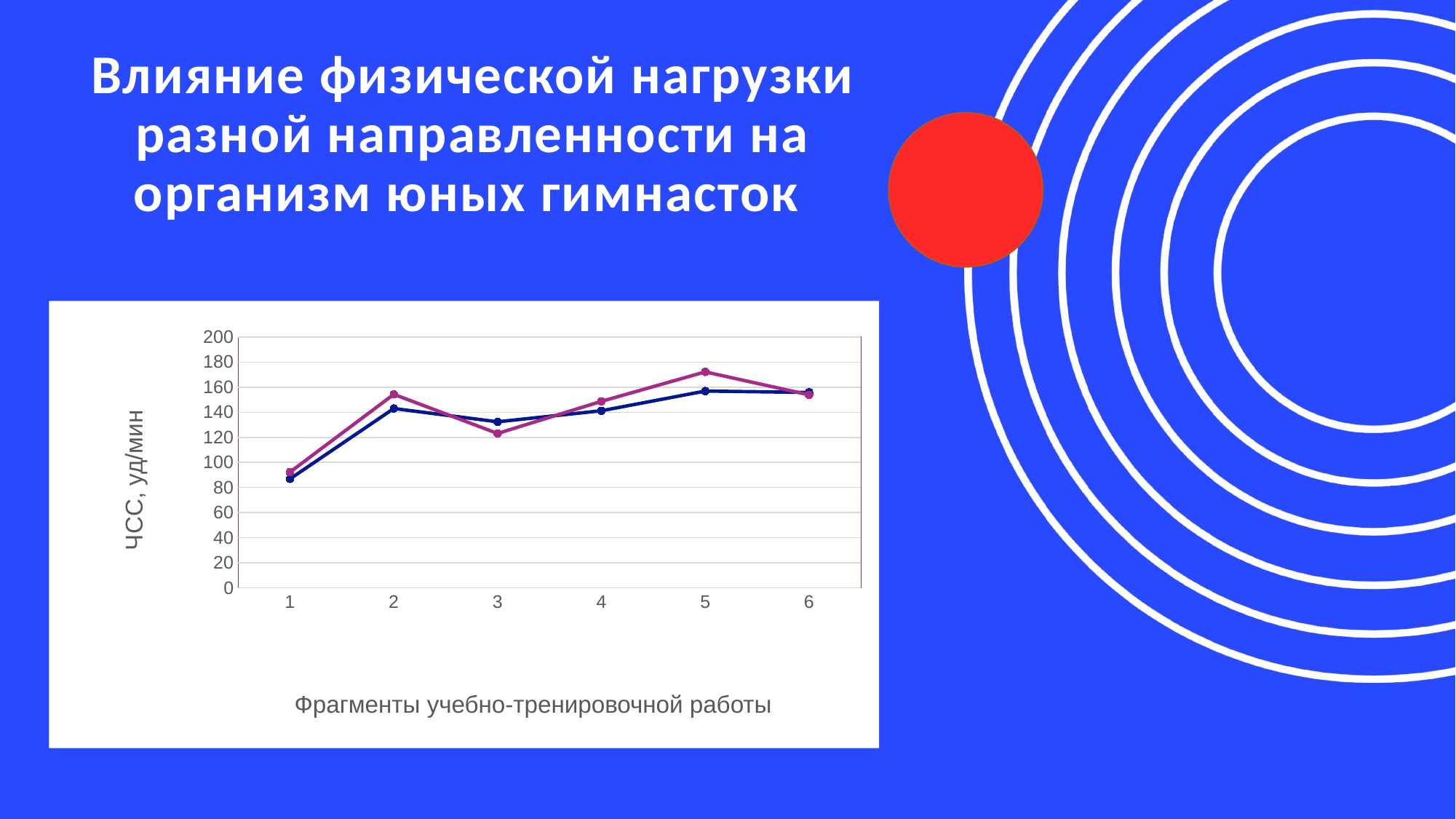
How many fragments (points) are plotted along the x axis of the chart? 6 At which fragment does the pink line have its lowest value? 1 Do the values of both lines rise or fall from fragment 1 to fragment 2? rise At fragment 2, which line is higher, the pink line or the dark blue line? pink line Is the value of the dark blue line at fragment 1 greater or less than 100? less Is the value of the pink line at fragment 5 greater or less than 160? greater At which fragment does the pink line reach its highest value? 5 How many lines (series) are plotted on the chart? 2 What is the label of the vertical axis of the chart? ЧСС, уд/мин What kind of chart is shown on the slide? line chart Is the value of the pink line at fragment 3 greater or less than 140? less At fragment 3, which line is higher, the pink line or the dark blue line? dark blue line